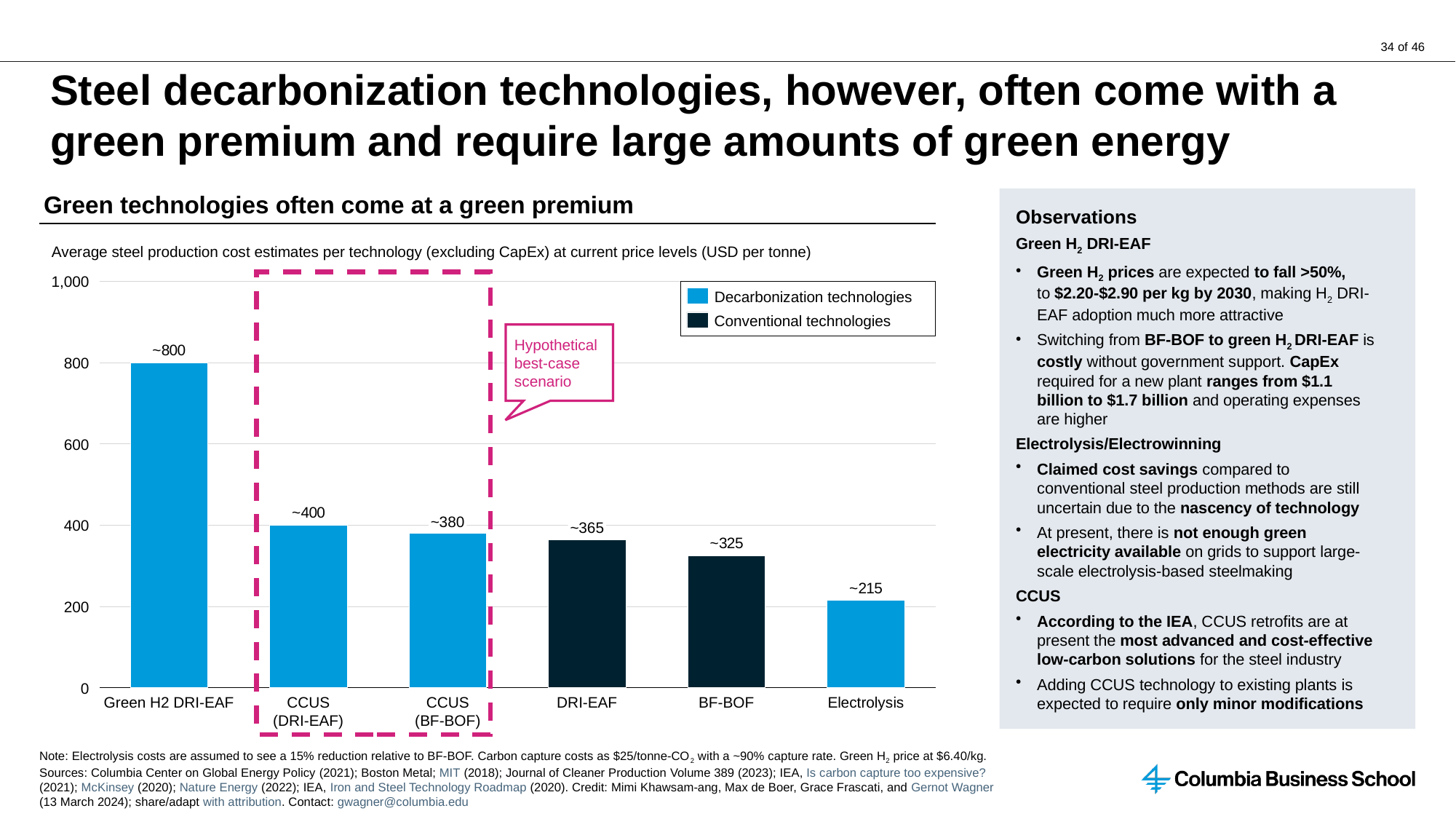
How many series does the legend list? 2 Is the value for BF-BOF greater or less than 400? less What is the data label shown for CCUS (BF-BOF)? ~380 Which has a higher production cost, DRI-EAF or BF-BOF? DRI-EAF What is the data label shown for Green H2 DRI-EAF? ~800 Which technology has the highest production cost in the chart? Green H2 DRI-EAF Which legend series is shown in dark navy? Conventional technologies What kind of chart is shown on the slide? Bar chart Which technology has the lowest production cost in the chart? Electrolysis How many technologies (bars) are shown in the chart? 6 Which two technologies are enclosed in the dashed box labelled 'Hypothetical best-case scenario'? CCUS (DRI-EAF) and CCUS (BF-BOF) What is the data label shown for Electrolysis? ~215